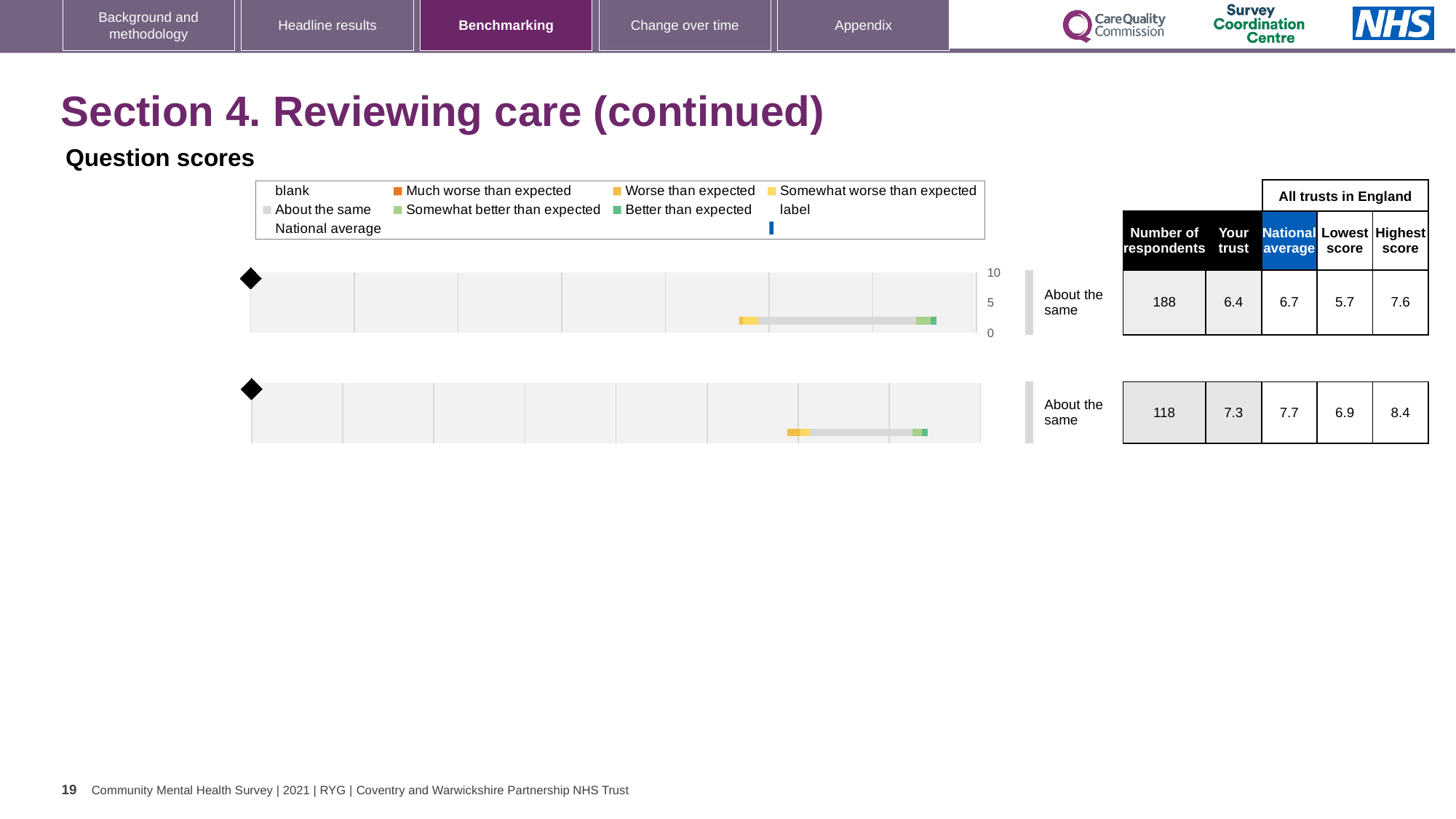
For the top chart row, what is the 'Your trust' score? 6.4 For the bottom chart row, what is the highest score among all trusts in England? 8.4 What kind of chart is used for the question score rows on this slide? bar chart For the top chart row, how much higher is the national average than the 'Your trust' score? 0.3 For the top chart row, is the 'Your trust' score greater or less than 5? greater For the bottom chart row, what is the 'Your trust' score? 7.3 For the top chart row, how many respondents are there? 188 For the top chart row, what is the national average score? 6.7 For the bottom chart row, what is the difference between the highest score and the lowest score? 1.5 How many question score rows (charts) are shown on the slide? 2 What benchmark category is shown next to both chart rows? About the same For the top chart row, which is larger: the 'Your trust' score or the national average? National average